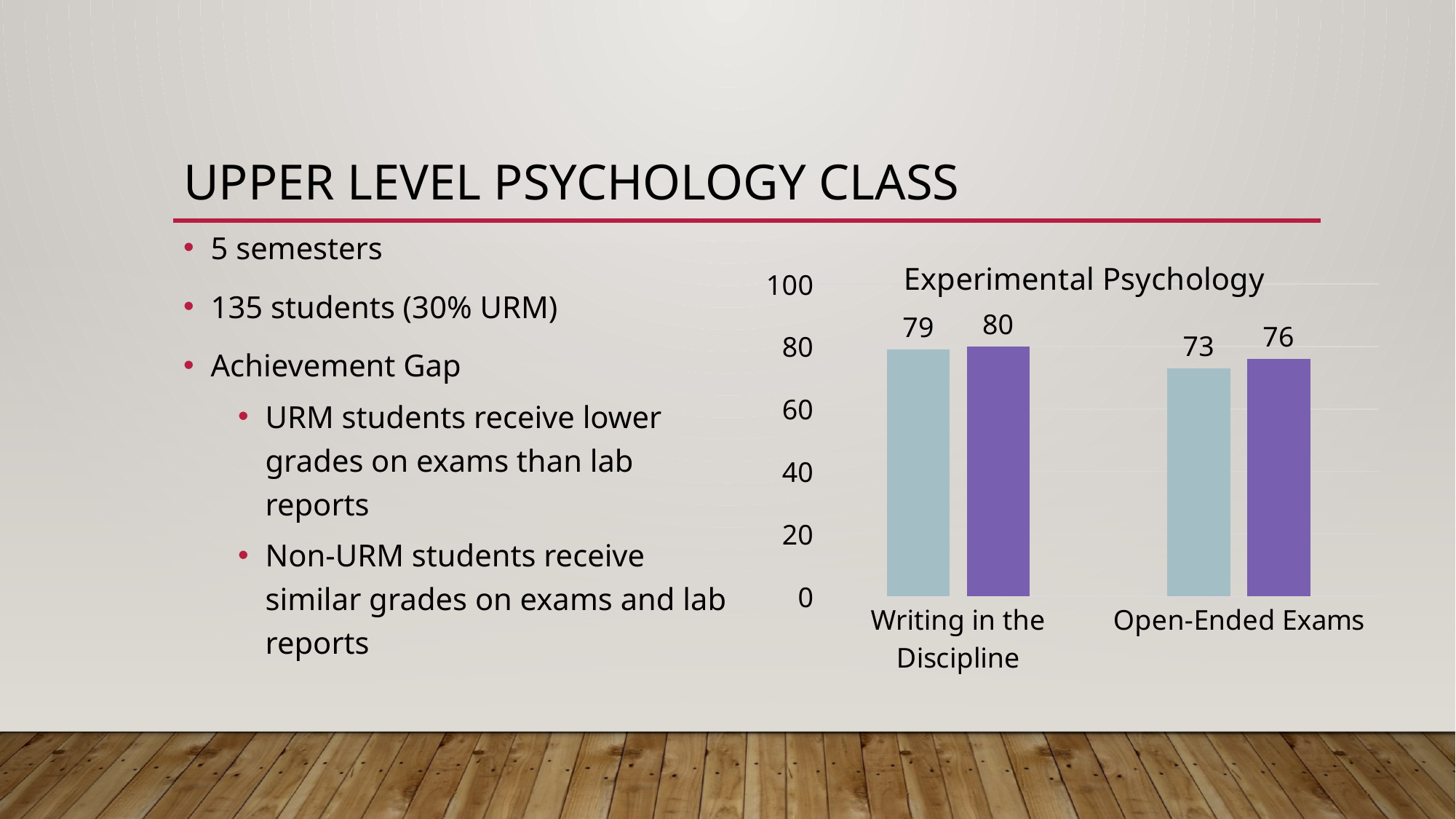
What kind of chart is shown on the slide? bar chart What is the value of the purple bar for Open-Ended Exams? 76 What is the value of the purple bar for Writing in the Discipline? 80 Which bar has the highest value in the chart? the purple bar for Writing in the Discipline (80) How many categories are shown on the x axis of the chart? 2 Which is larger: the light blue bar for Writing in the Discipline or the light blue bar for Open-Ended Exams? Writing in the Discipline What is the difference between the purple and light blue bars for Open-Ended Exams? 3 Which bar has the lowest value in the chart? the light blue bar for Open-Ended Exams (73) What is the value of the light blue bar for Open-Ended Exams? 73 What is the value of the light blue bar for Writing in the Discipline? 79 What is the title of the chart? Experimental Psychology Is the value of the purple bar for Open-Ended Exams greater or less than 80? less